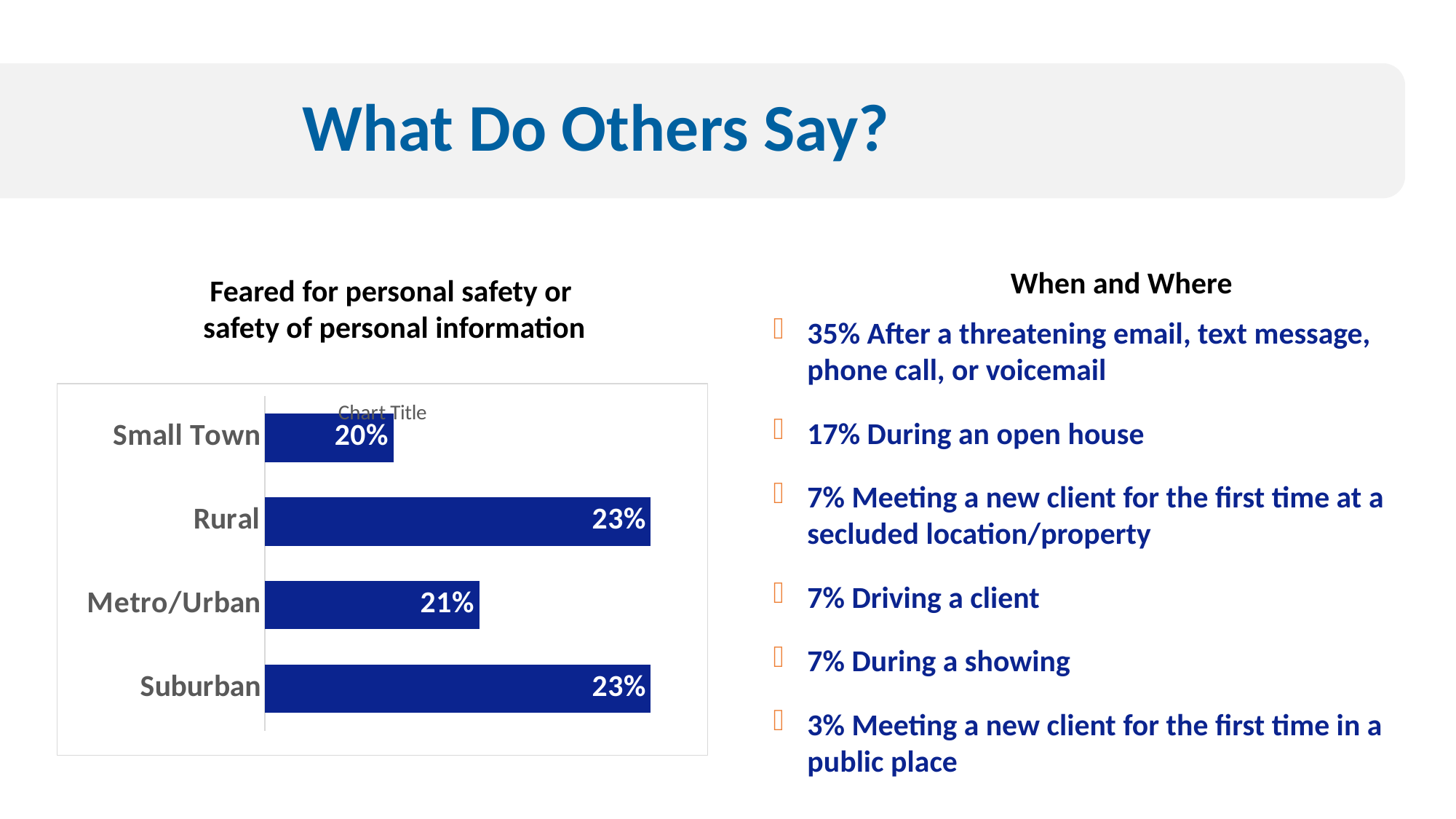
What is the heading printed above the chart? Feared for personal safety or safety of personal information What is the difference between the values for Rural and Small Town? 3% What is the value for Suburban in the chart? 23% Which is larger, the value for Rural or the value for Metro/Urban? Rural Which is larger, the value for Suburban or the value for Small Town? Suburban What is the value for Rural in the chart? 23% What kind of chart is shown on the slide? bar chart What is the value for Metro/Urban in the chart? 21% What is the value for Small Town in the chart? 20% How many categories are shown in the chart? 4 Which category has the lowest value in the chart? Small Town What is the difference between the values for Suburban and Metro/Urban? 2%